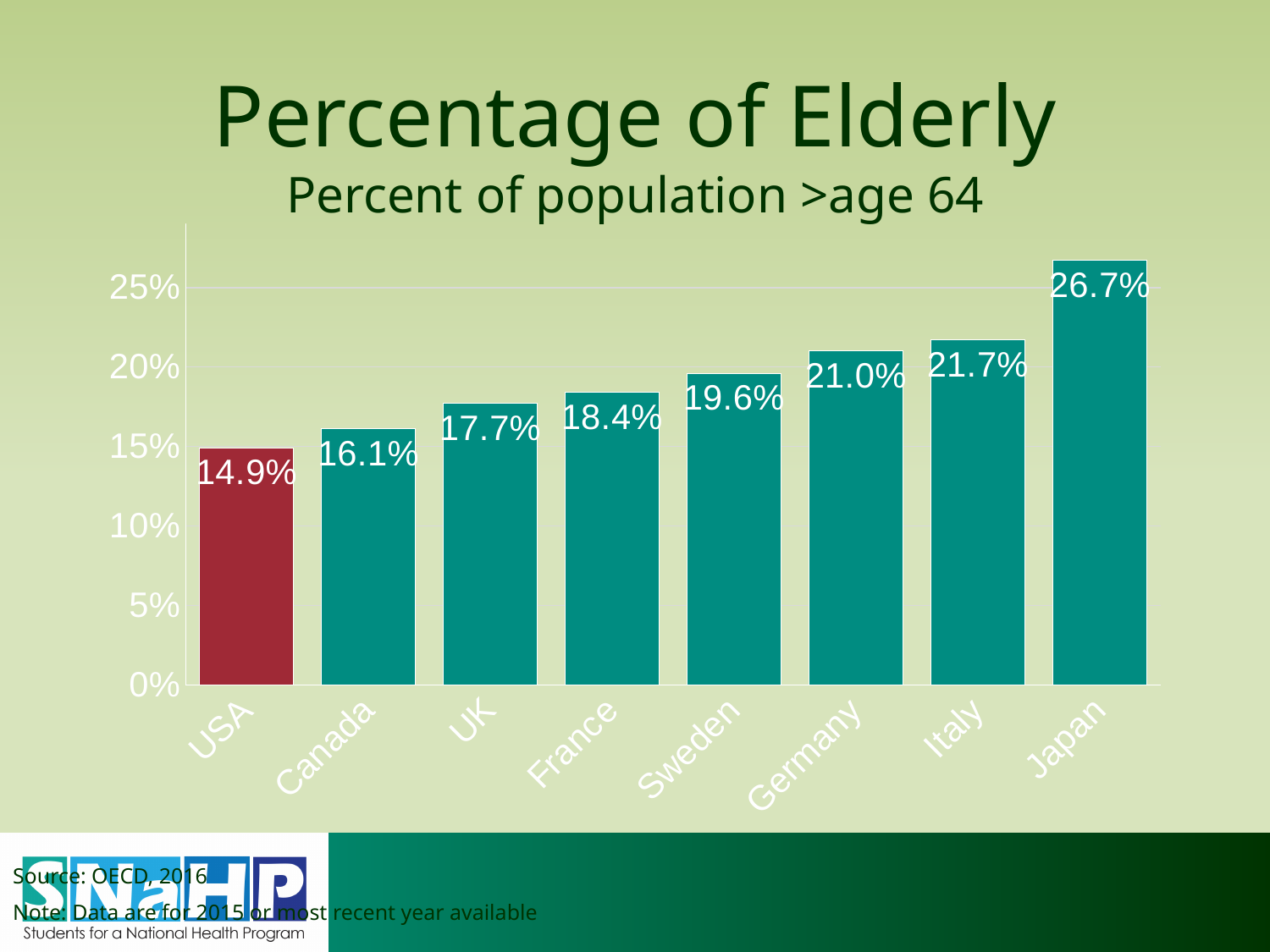
Which has a higher percentage of elderly, France or the UK? France Which country has the highest percentage of elderly? Japan What is the percentage of elderly for Sweden? 19.6% What kind of chart is shown on the slide? Bar chart Is the value for Germany greater or less than 20%? greater How many countries are shown in the chart? 8 What is the percentage of elderly for Germany? 21.0% What is the difference between Italy's and Canada's percentage of elderly? 5.6% Which bar is shown in a different colour from the others? USA What is the percentage of elderly for the USA? 14.9% What is the difference between Japan's and the USA's percentage of elderly? 11.8% Which country has the lowest percentage of elderly? USA